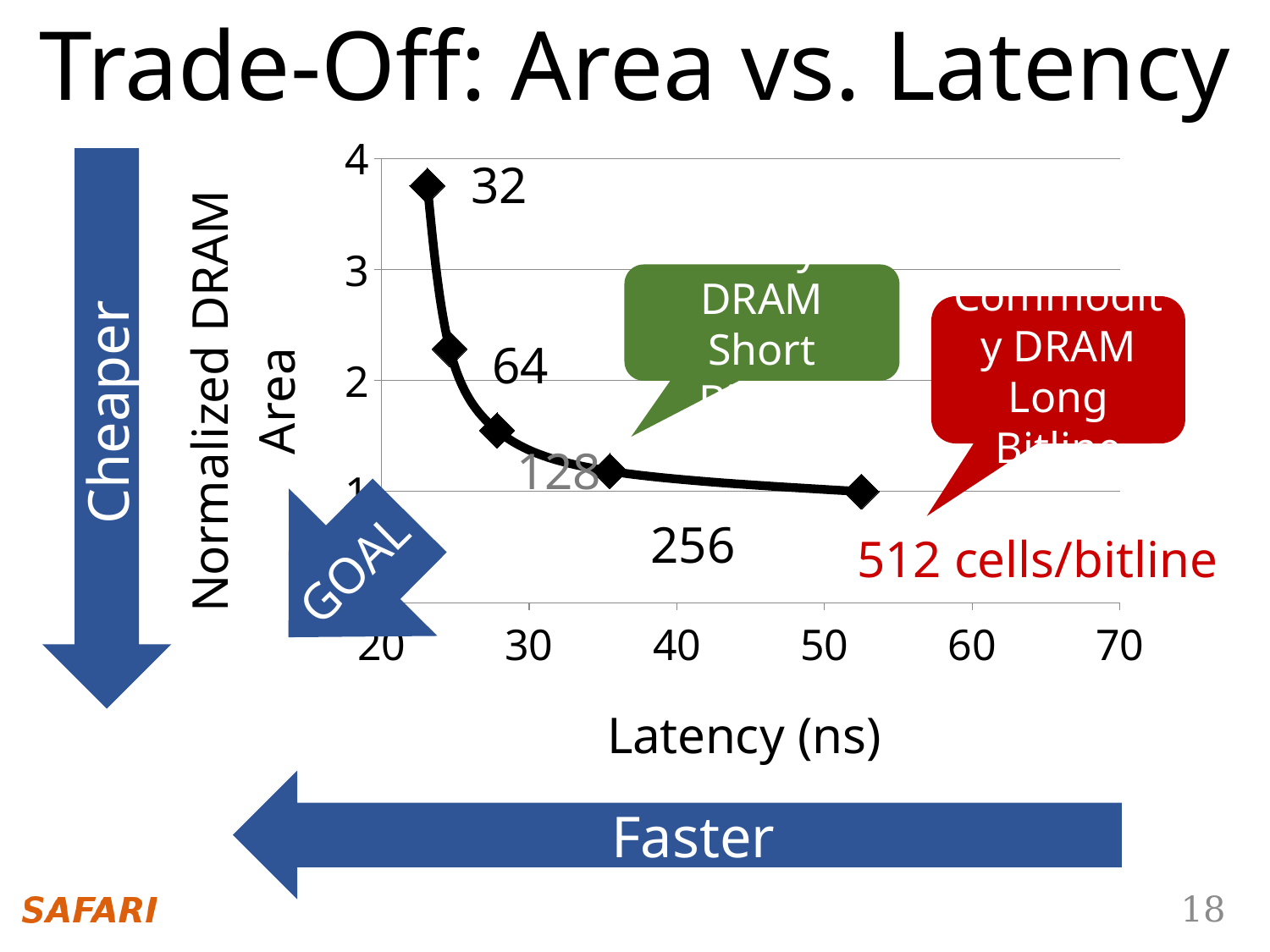
What kind of chart is shown on the slide? line chart Is the latency for 32 cells/bitline greater or less than 30 ns? less Is the normalized DRAM area for 32 cells/bitline greater or less than 3? greater Is the latency for 512 cells/bitline greater or less than 40 ns? greater Which cells/bitline configuration has the lowest normalized DRAM area? 512 Which cells/bitline configuration has the highest latency? 512 Which cells/bitline configuration has the lowest latency? 32 How many data points are plotted on the chart? 5 Which has a larger normalized DRAM area, 64 cells/bitline or 256 cells/bitline? 64 cells/bitline As latency increases along the x axis, does the normalized DRAM area rise or fall? fall Which cells/bitline configuration has the highest normalized DRAM area? 32